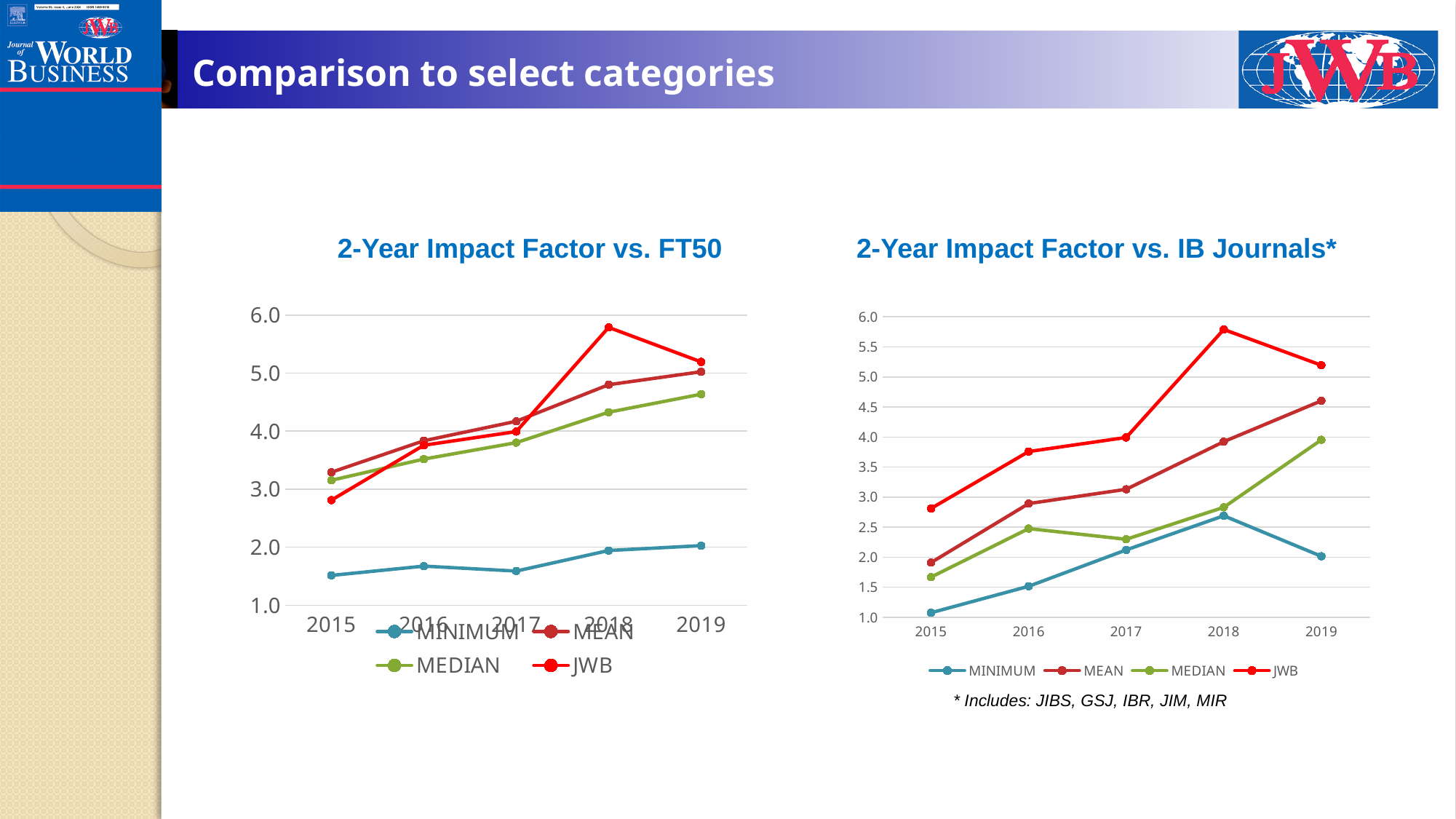
In the '2-Year Impact Factor vs. IB Journals*' chart, which series has the lowest value in 2015? MINIMUM How many series does the legend of the '2-Year Impact Factor vs. IB Journals*' chart list? 4 In the '2-Year Impact Factor vs. IB Journals*' chart, is the MINIMUM value for 2015 greater or less than 1.5? less In the '2-Year Impact Factor vs. IB Journals*' chart, is the MEAN value for 2019 greater or less than 4.0? greater In the '2-Year Impact Factor vs. FT50' chart, is the JWB value for 2018 greater or less than 5.0? greater Which journals does the asterisk note under the '2-Year Impact Factor vs. IB Journals*' chart say are included? JIBS, GSJ, IBR, JIM, MIR In the '2-Year Impact Factor vs. FT50' chart, which is larger in 2015, the MEAN value or the JWB value? MEAN In the '2-Year Impact Factor vs. FT50' chart, in which year does the JWB series reach its highest value? 2018 What kind of chart is the '2-Year Impact Factor vs. FT50' chart? line chart In the '2-Year Impact Factor vs. IB Journals*' chart, does the MEAN series rise or fall from 2015 to 2019? rise How many years are plotted on the x axis of the '2-Year Impact Factor vs. FT50' chart? 5